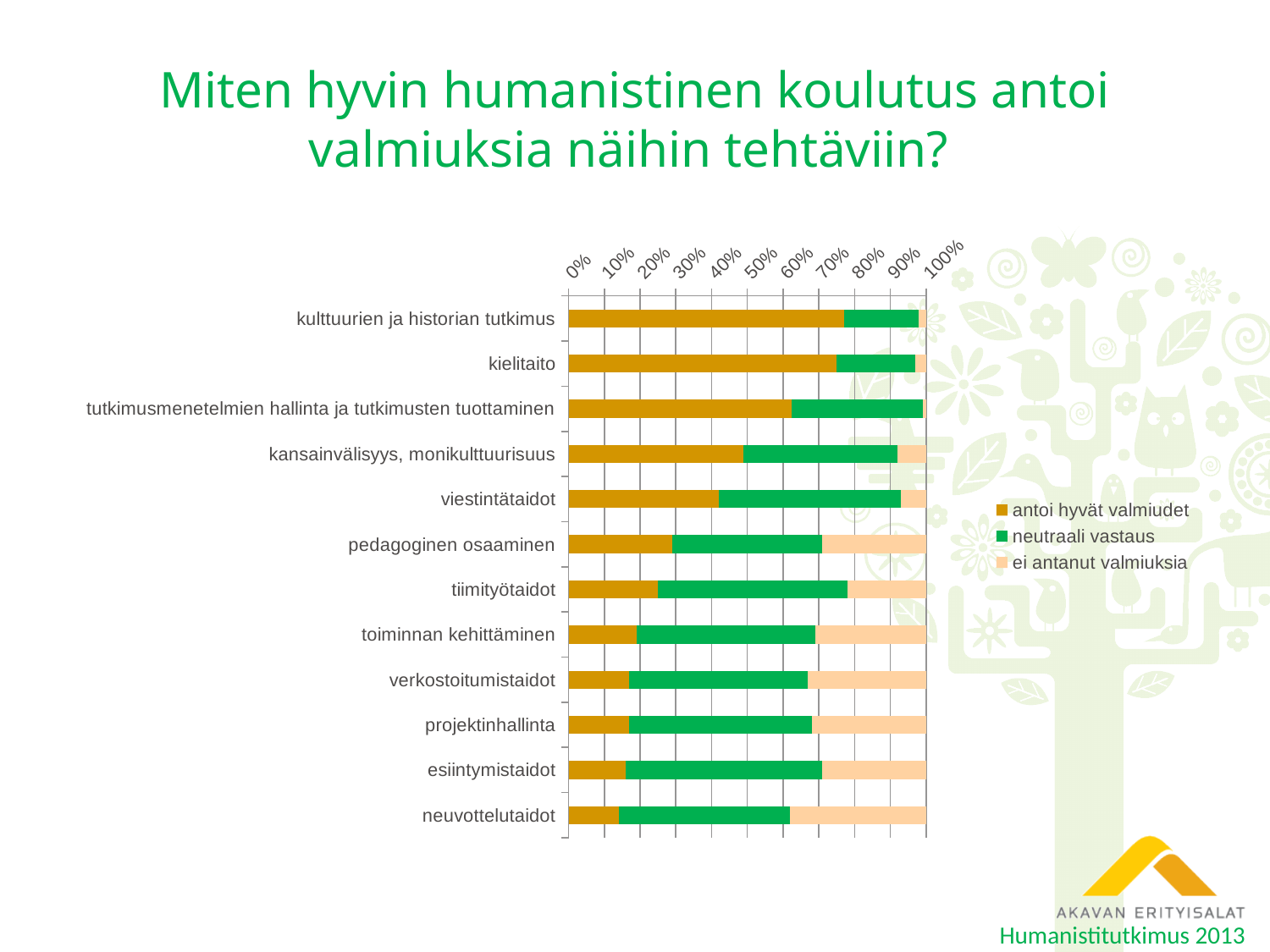
What kind of chart is shown on the slide? Stacked bar chart Is the 'antoi hyvät valmiudet' share for neuvottelutaidot greater or less than 20%? less Is the 'antoi hyvät valmiudet' share for kulttuurien ja historian tutkimus greater or less than 70%? greater Which category has the largest 'ei antanut valmiuksia' share? neuvottelutaidot Is the 'antoi hyvät valmiudet' share for tutkimusmenetelmien hallinta ja tutkimusten tuottaminen greater or less than 50%? greater What is the title of the slide? Miten hyvin humanistinen koulutus antoi valmiuksia näihin tehtäviin? Which has a larger 'antoi hyvät valmiudet' share: kielitaito or viestintätaidot? kielitaito What are the three legend entries of the chart? antoi hyvät valmiudet, neutraali vastaus, ei antanut valmiuksia How many series does the legend list? 3 How many categories (tasks) are listed on the chart? 12 Which has a larger 'ei antanut valmiuksia' share: pedagoginen osaaminen or kulttuurien ja historian tutkimus? pedagoginen osaaminen